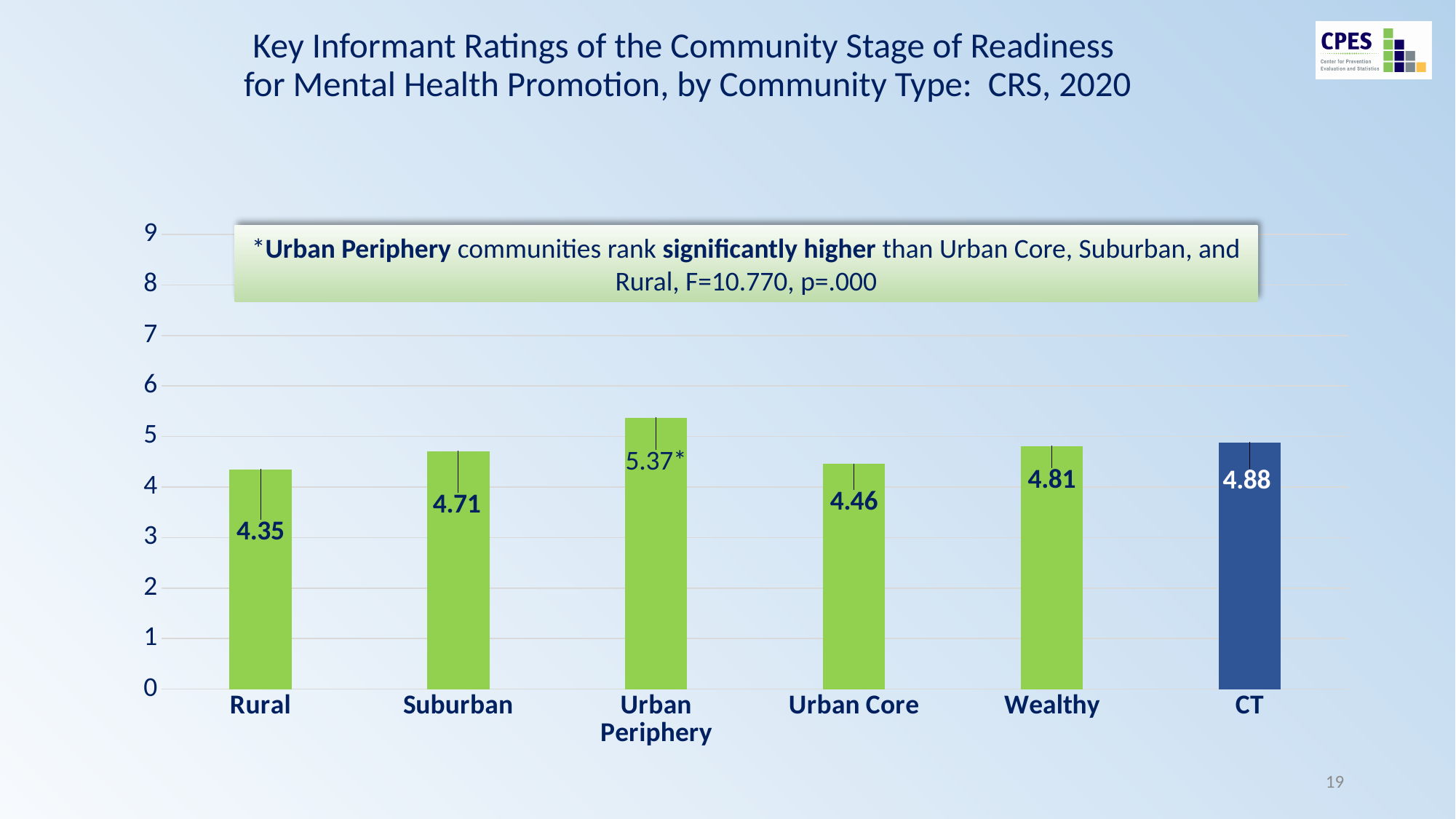
What is the rating for CT? 4.88 What is the rating for Rural communities? 4.35 Is the value for Urban Periphery greater or less than 5? greater What is the difference between the Wealthy rating and the Urban Core rating? 0.35 Which bar is shown in a different colour (dark blue) from the others? CT How many community types are shown on the chart? 6 Which has a higher rating, Suburban or Urban Core? Suburban What is the difference between the Urban Periphery rating and the Rural rating? 1.02 Which community type has the highest rating? Urban Periphery What is the rating for Urban Periphery communities? 5.37 Which community type has the lowest rating? Rural What kind of chart is shown on the slide? Bar chart